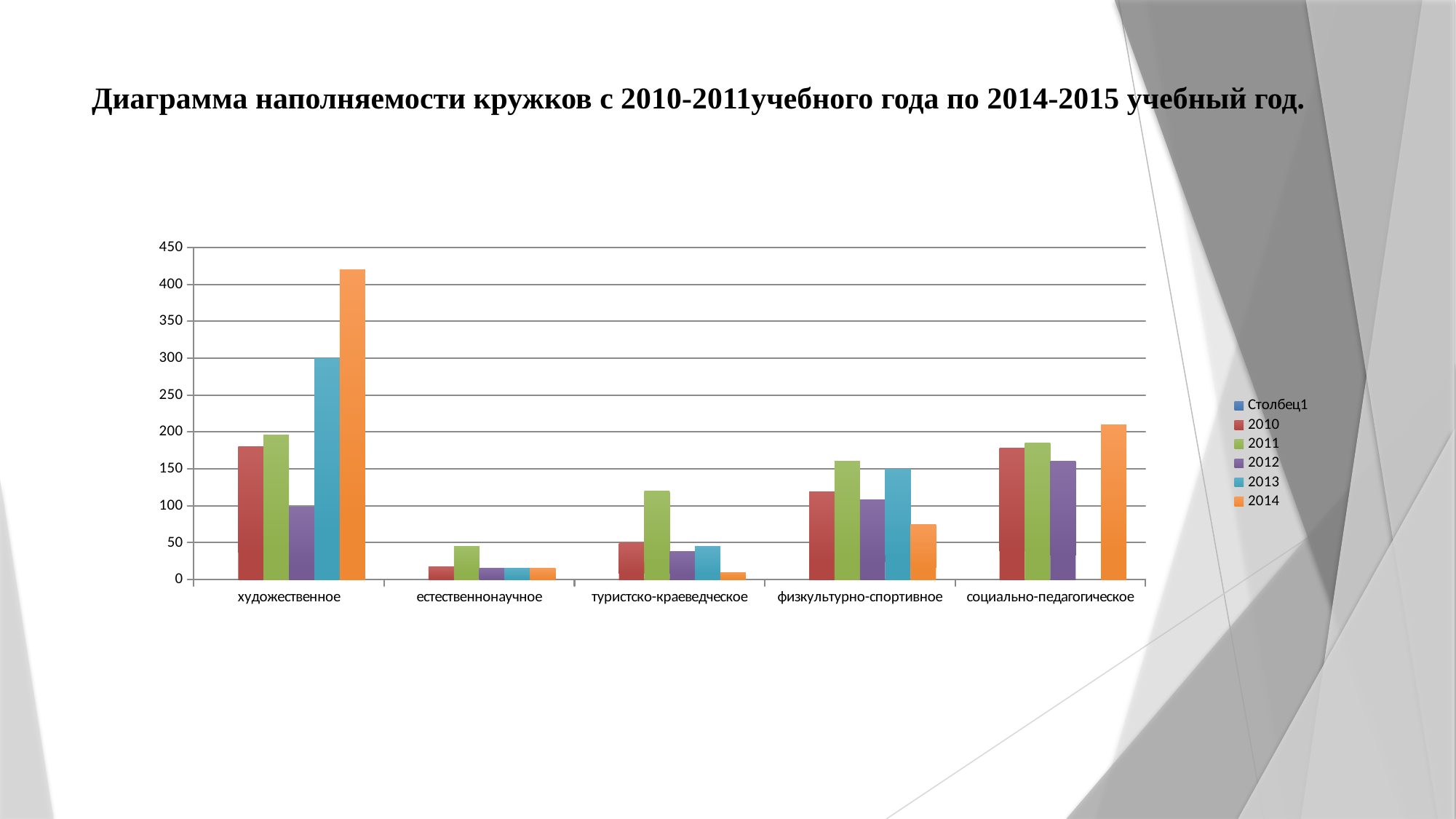
Which category has the lowest bar for the 2011 series? естественнонаучное What is the title of the slide containing the chart? Диаграмма наполняемости кружков с 2010-2011учебного года по 2014-2015 учебный год. How many categories are shown along the x axis of the chart? 5 What kind of chart is shown on the slide? bar chart Is the 2014 value for художественное greater or less than 400? greater How many series does the chart's legend list? 6 What is the 2013 value for художественное? 300 Which category has the highest bar for the 2014 series? художественное Is the 2014 value for социально-педагогическое greater or less than 200? greater For физкультурно-спортивное, which is larger: the 2010 value or the 2011 value? 2011 Is the 2013 value for физкультурно-спортивное greater or less than 200? less For the 2014 series, which is larger: социально-педагогическое or физкультурно-спортивное? социально-педагогическое